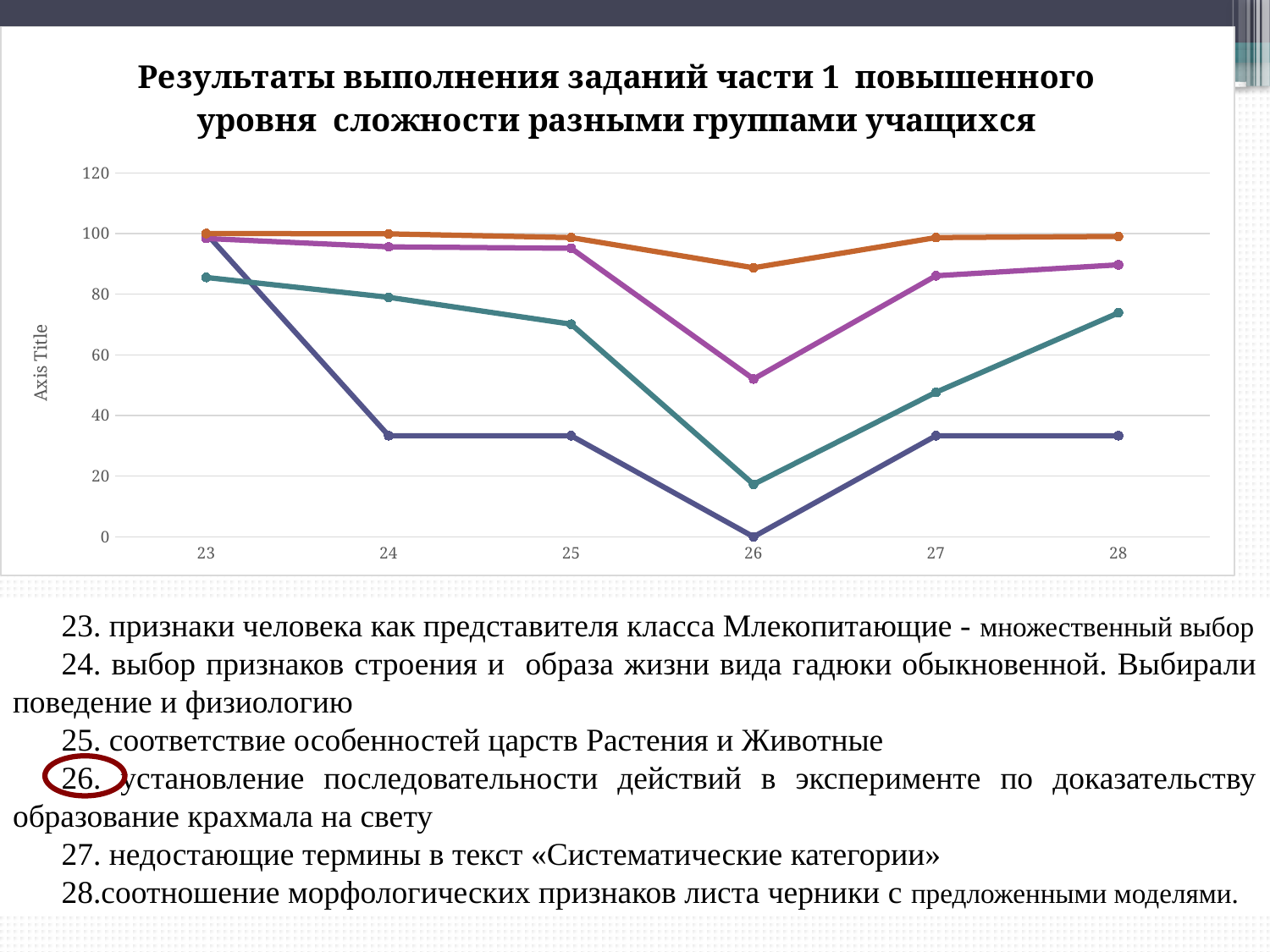
How many categories are shown on the x axis of the chart? 6 Is the value of the teal line at category 26 greater or less than 40? less Is the value of the purple line at category 26 greater or less than 60? less What type of chart is shown on the slide? line chart How many lines are plotted on the chart? 4 What is the title of the chart? Результаты выполнения заданий части 1 повышенного уровня сложности разными группами учащихся Is the value of the dark blue line at category 24 greater or less than 40? less At which category does the teal line reach its highest value? 23 At category 24, which line has the larger value, the orange line or the dark blue line? orange line At which category does the orange line reach its lowest value? 26 What is the value of the dark blue line at category 26? 0